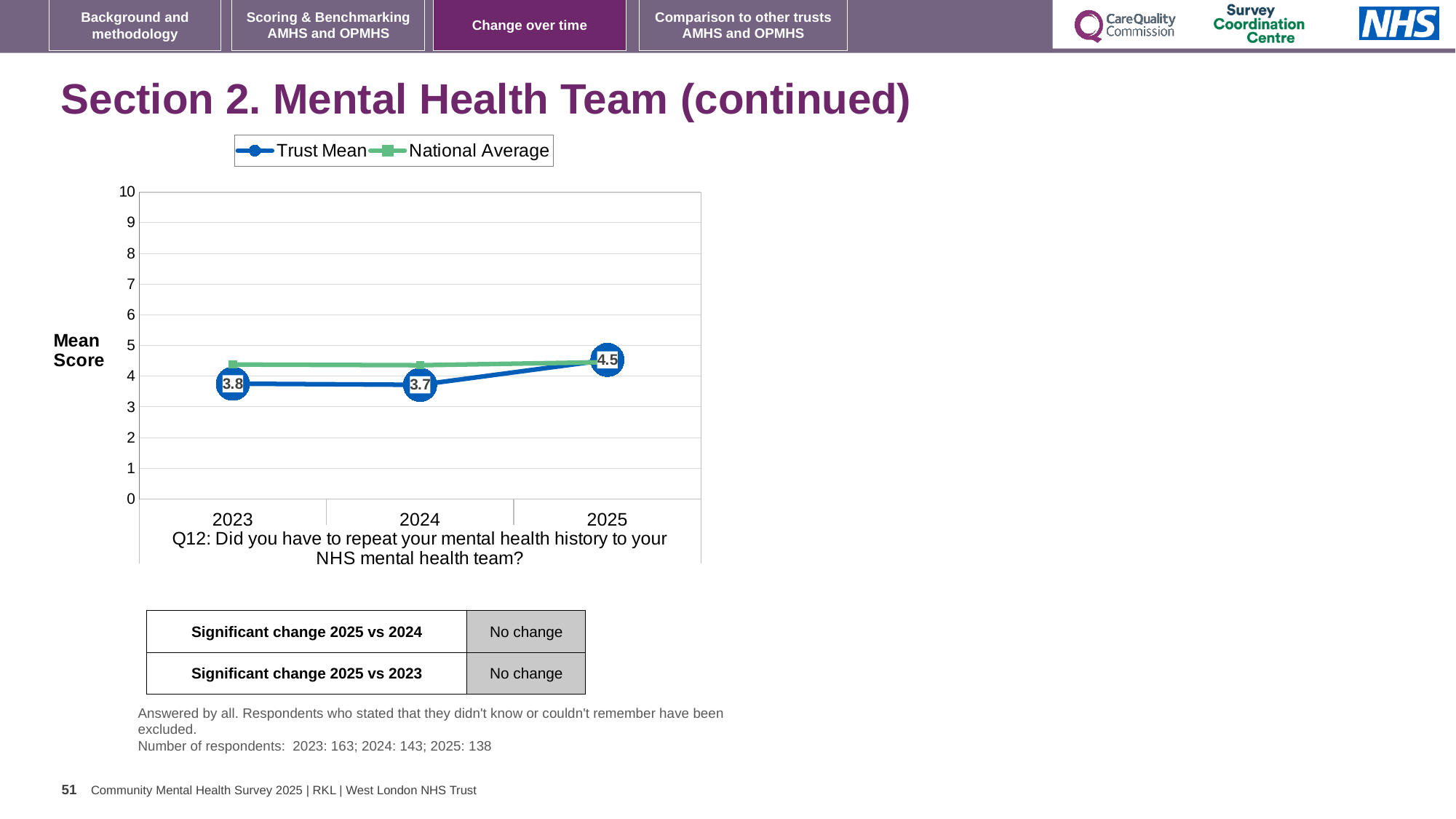
What is the Trust Mean score for 2023? 3.8 Is the National Average value for 2024 greater or less than 4? greater What is the difference between the Trust Mean score in 2025 and in 2024? 0.8 In which year is the Trust Mean score highest? 2025 What is the Trust Mean score for 2025? 4.5 How many series does the legend list? 2 How many years are plotted on the x axis? 3 What kind of chart is shown on the slide? Line chart What is the Trust Mean score for 2024? 3.7 In which year is the Trust Mean score lowest? 2024 Does the Trust Mean rise or fall from 2024 to 2025? Rise In 2023, which is higher: the Trust Mean or the National Average? National Average